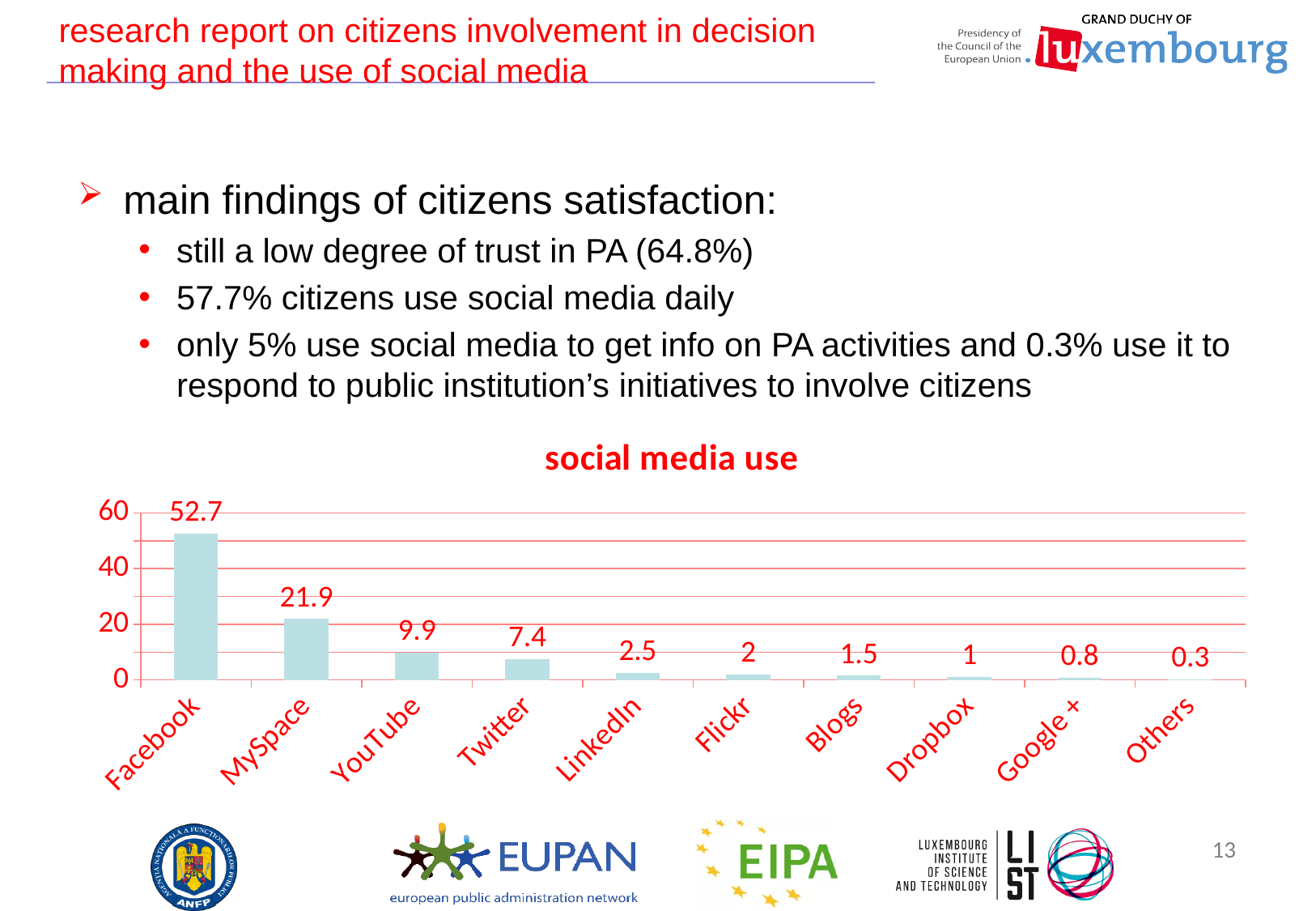
How many categories are shown on the x axis of the social media use chart? 10 Which has a larger value, YouTube or Twitter? YouTube What is the value for Twitter in the social media use chart? 7.4 Which category has the highest value in the social media use chart? Facebook Is the value for MySpace greater or less than 20? greater What is the title of the chart on the slide? social media use What is the value for MySpace in the social media use chart? 21.9 What kind of chart is shown on the slide? bar chart What is the value for Google + in the social media use chart? 0.8 Which category has the lowest value in the social media use chart? Others What is the difference between the values for Facebook and MySpace? 30.8 What is the value for Facebook in the social media use chart? 52.7